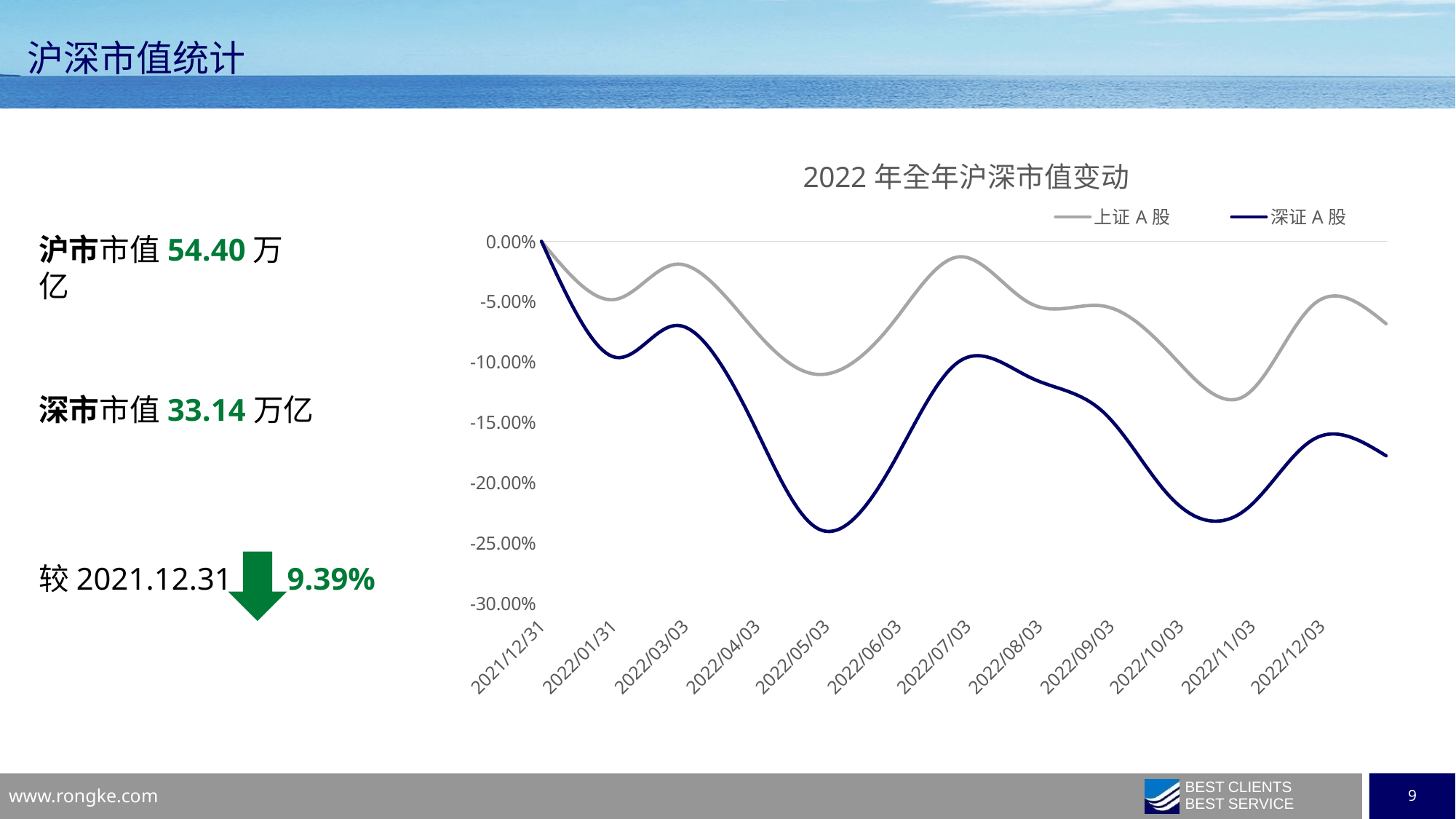
At 2022/05/03, which series has the higher value, 上证 A 股 or 深证 A 股? 上证 A 股 Which colour is used for the 深证 A 股 line? dark blue What kind of chart is shown on the slide? line chart Is the value for 上证 A 股 at 2022/05/03 greater or less than -5.00%? less What is the title of the chart? 2022 年全年沪深市值变动 Is the value for 上证 A 股 at 2022/11/03 greater or less than -10.00%? less How many series does the chart legend list? 2 How many date labels are shown on the x axis of the chart? 12 Around which x-axis date does the 深证 A 股 line reach its lowest value? 2022/05/03 Is the value for 深证 A 股 at 2022/07/03 greater or less than -15.00%? greater Does the 深证 A 股 line rise or fall overall from 2021/12/31 to 2022/05/03? fall